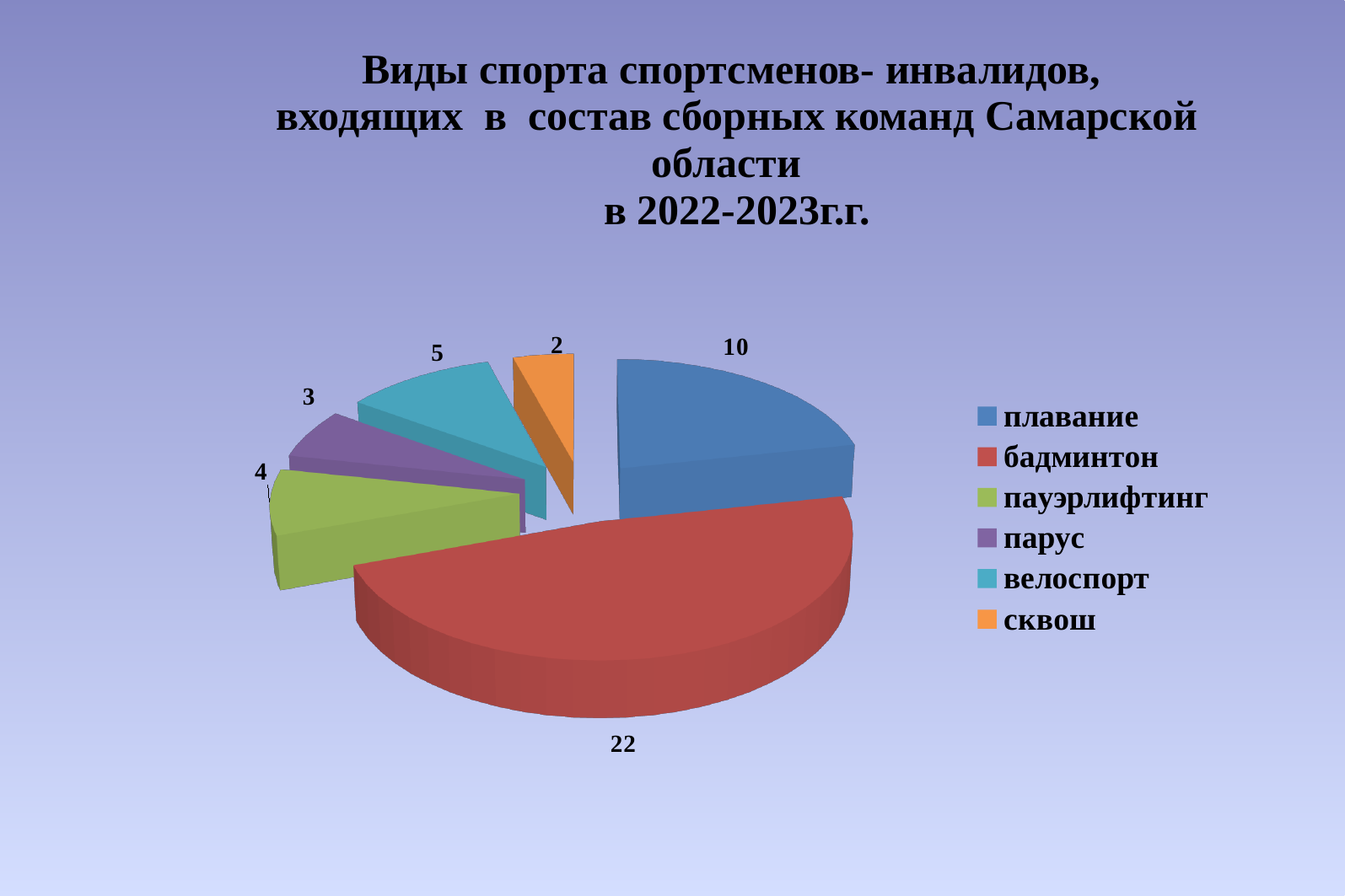
Which sport has the smallest slice of the pie? сквош Which is larger, the value for пауэрлифтинг or the value for парус? пауэрлифтинг How many sports (slices) are shown in the pie chart? 6 What is the value for плавание? 10 Which colour represents велоспорт in the legend? teal (light blue) What is the difference between the values for бадминтон and плавание? 12 What is the total of all the values shown in the pie chart? 46 What is the value for велоспорт? 5 What kind of chart is shown on the slide? pie chart What is the value for бадминтон? 22 What is the value for сквош? 2 Which sport has the largest slice of the pie? бадминтон